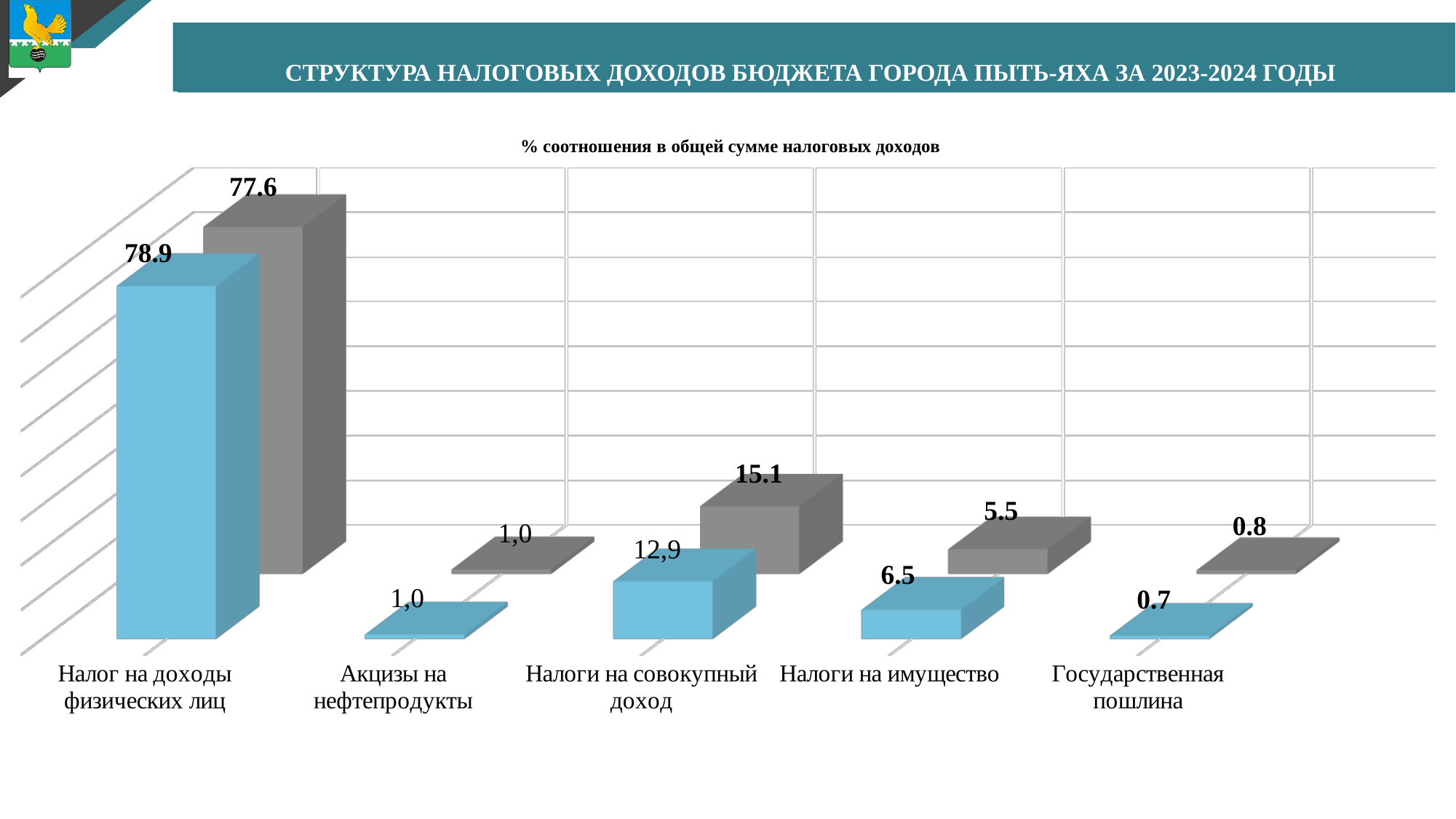
How many categories are shown on the x axis? 5 What is the value of the grey bar for Государственная пошлина? 0.8 Which category has the lowest value in the blue series? Государственная пошлина What is the value of the grey bar for Налог на доходы физических лиц? 77.6 What is the value of the blue bar for Налоги на имущество? 6.5 Which category has the highest value in the blue series? Налог на доходы физических лиц For Налоги на имущество, which bar is larger, the blue or the grey one? blue What is the value of the grey bar for Налоги на совокупный доход? 15.1 What is the difference between the blue and grey bars for Налог на доходы физических лиц? 1.3 What type of chart is shown on the slide? bar chart What is the difference between the grey and blue bars for Налоги на совокупный доход? 2.2 What is the value of the blue bar for Налог на доходы физических лиц? 78.9